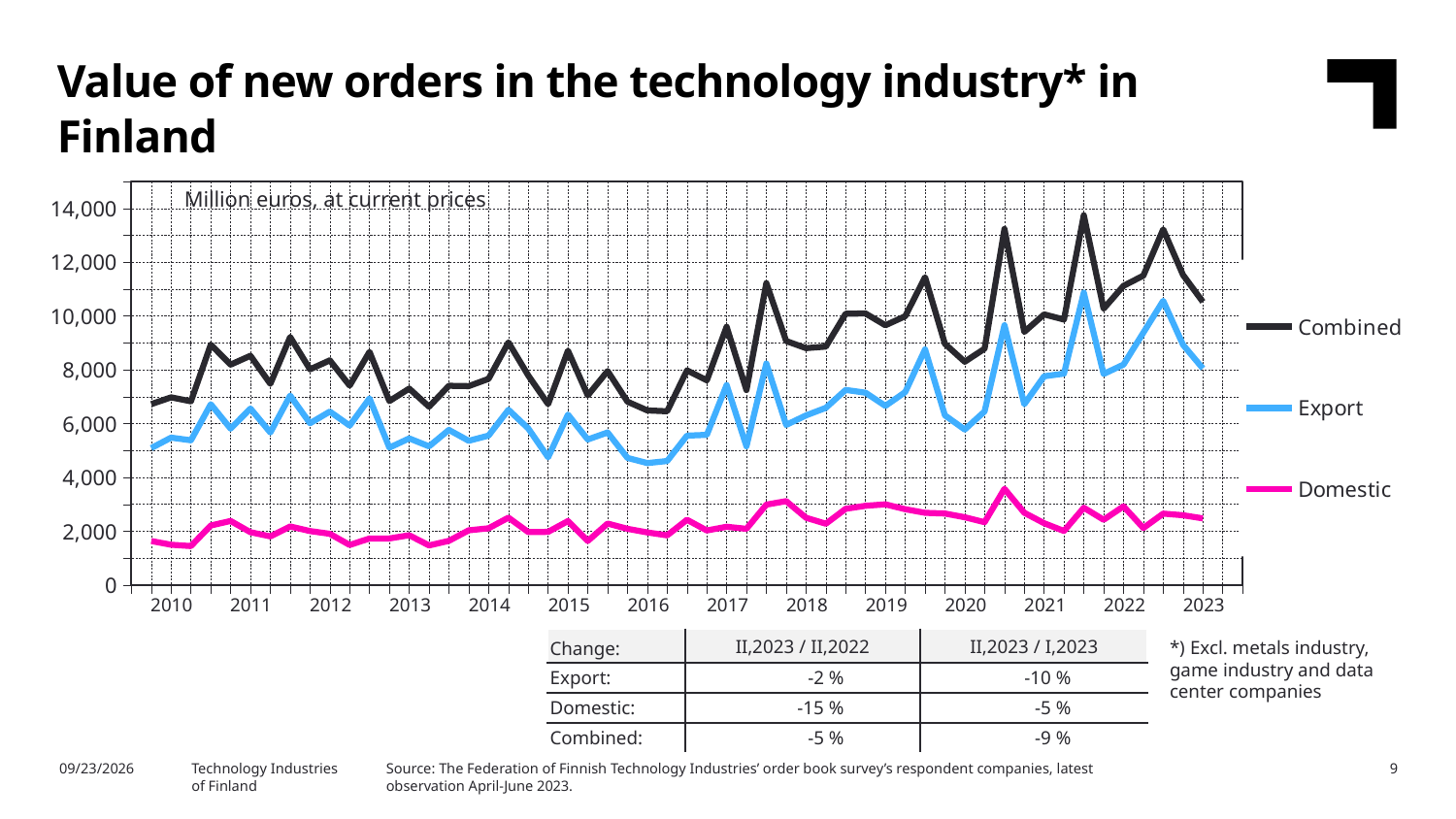
Is the lowest Export value in 2016 greater or less than 6,000? less Is the Export value at the end of 2023 greater or less than 10,000? less Is the Domestic value at the end of 2023 greater or less than 4,000? less Which series has the lowest values throughout the chart? Domestic What kind of chart is shown on the slide? Line chart Which is larger at the end of 2023, the Combined value or the Export value? Combined Which series has the highest values throughout the chart? Combined Which series are listed in the chart legend? Combined, Export, Domestic What unit is stated for the values in the chart? Million euros, at current prices How many series does the chart legend list? 3 Does the Combined series generally rise or fall between 2016 and 2021? rise